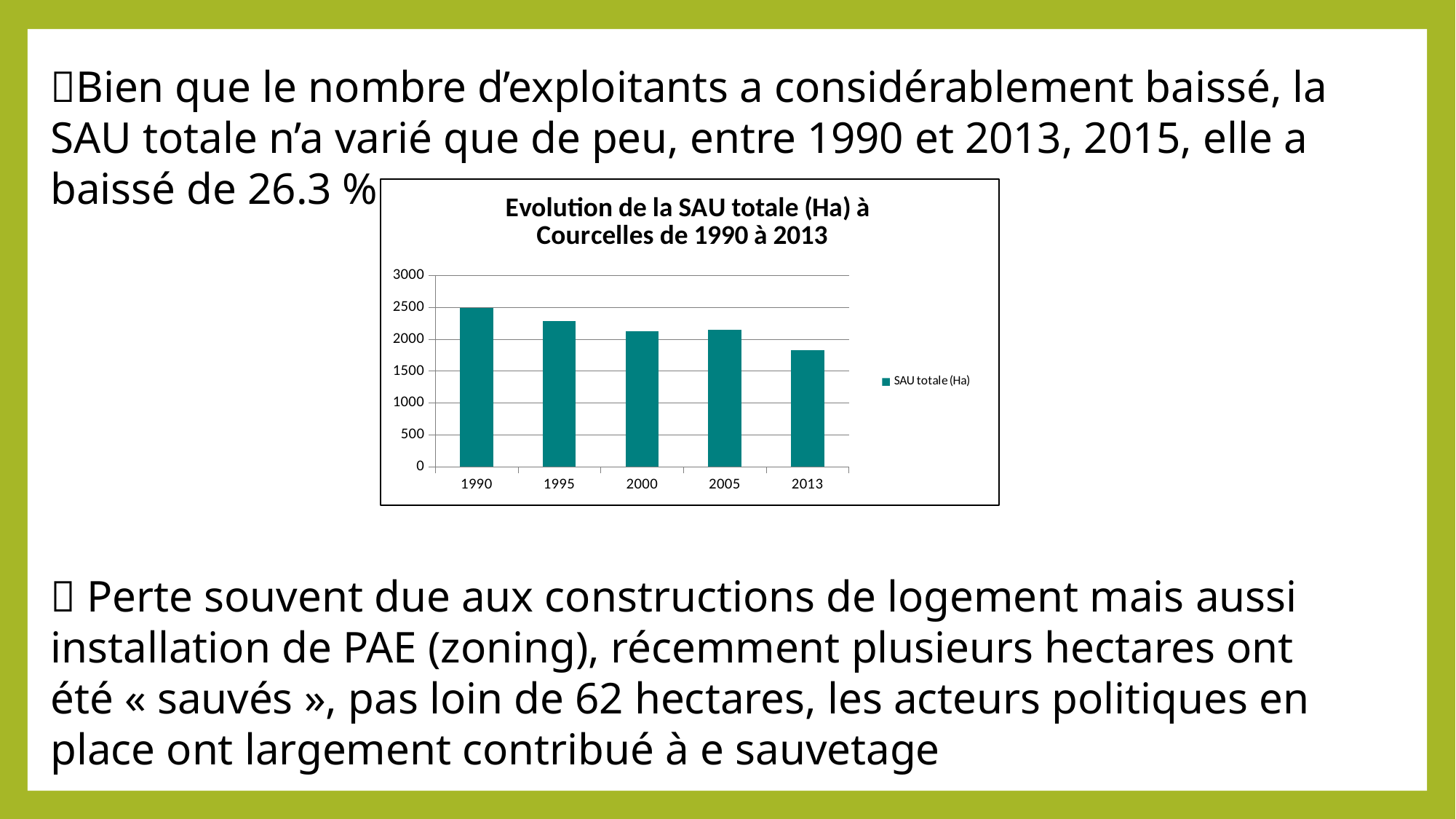
Overall, do the values rise or fall from 1990 to 2013? fall Is the value for 1995 greater or less than 2000? greater Is the value for 1990 greater or less than 2000? greater What is the series name shown in the chart legend? SAU totale (Ha) How many series does the chart legend list? 1 Is the value for 2013 greater or less than 2000? less Which year has the lowest SAU totale value? 2013 Which is larger, the value for 1990 or the value for 2013? 1990 What kind of chart is shown on the slide? bar chart Which year has the highest SAU totale value? 1990 How many years are shown on the x axis of the chart? 5